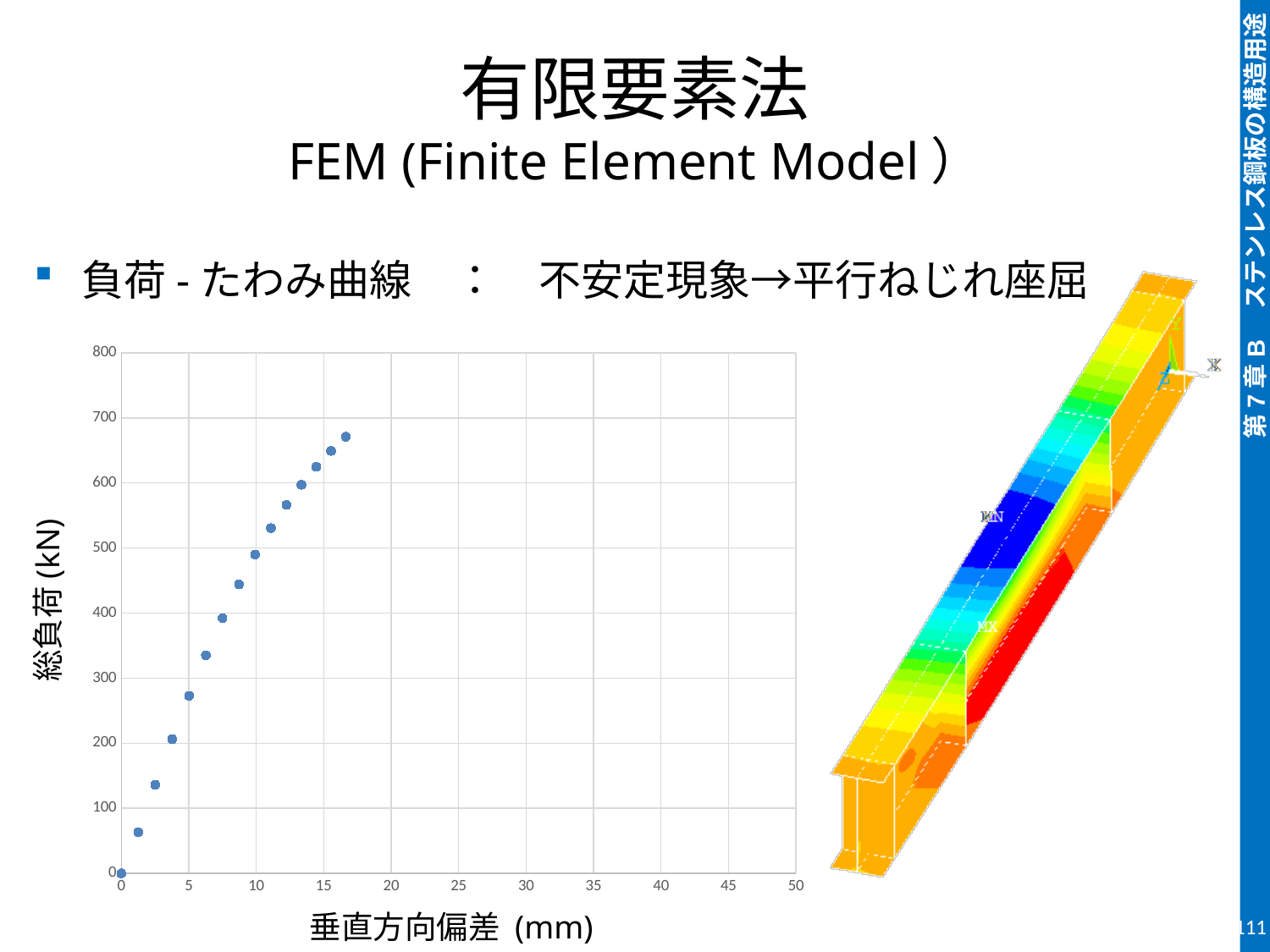
Is the load value at a vertical deviation of about 5 mm greater or less than 200 kN? greater Is the load value at a vertical deviation of about 10 mm greater or less than 400 kN? greater What is the maximum value shown on the vertical axis? 800 Is the load value at a vertical deviation of about 5 mm greater or less than 300 kN? less What kind of chart is shown on the slide? scatter chart What is the label of the vertical axis of the chart? 総負荷 (kN) Do the plotted values rise or fall as the horizontal deviation increases? rise What is the label of the horizontal axis of the chart? 垂直方向偏差 (mm) How many data points are plotted in the chart? 15